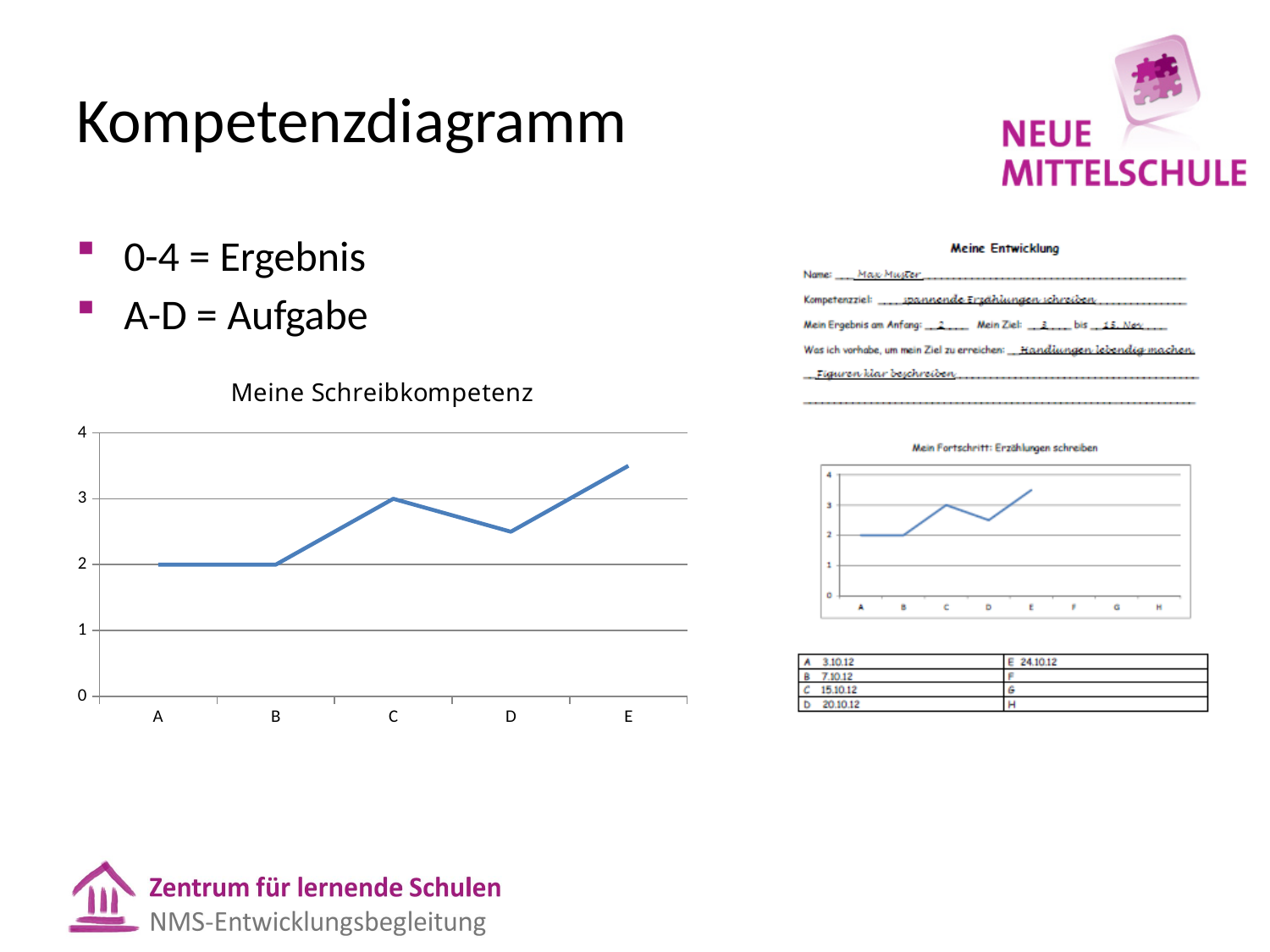
In the "Meine Schreibkompetenz" chart, what is the value for C? 3 In the "Meine Schreibkompetenz" chart, what is the difference between the value for C and the value for A? 1 In the "Meine Schreibkompetenz" chart, is the value for E greater or less than 3? greater In the "Meine Schreibkompetenz" chart, do the values overall rise or fall from A to E? rise What is the title of the line chart on the left of the slide? Meine Schreibkompetenz How many categories are shown on the x axis of the "Meine Schreibkompetenz" chart? 5 In the "Meine Schreibkompetenz" chart, which category has the highest value? E In the "Meine Schreibkompetenz" chart, which is larger, the value for C or the value for D? C In the "Meine Schreibkompetenz" chart, is the value for D greater or less than 3? less In the "Meine Schreibkompetenz" chart, what is the value for B? 2 What kind of chart is "Meine Schreibkompetenz"? line chart In the "Meine Schreibkompetenz" chart, what is the value for A? 2